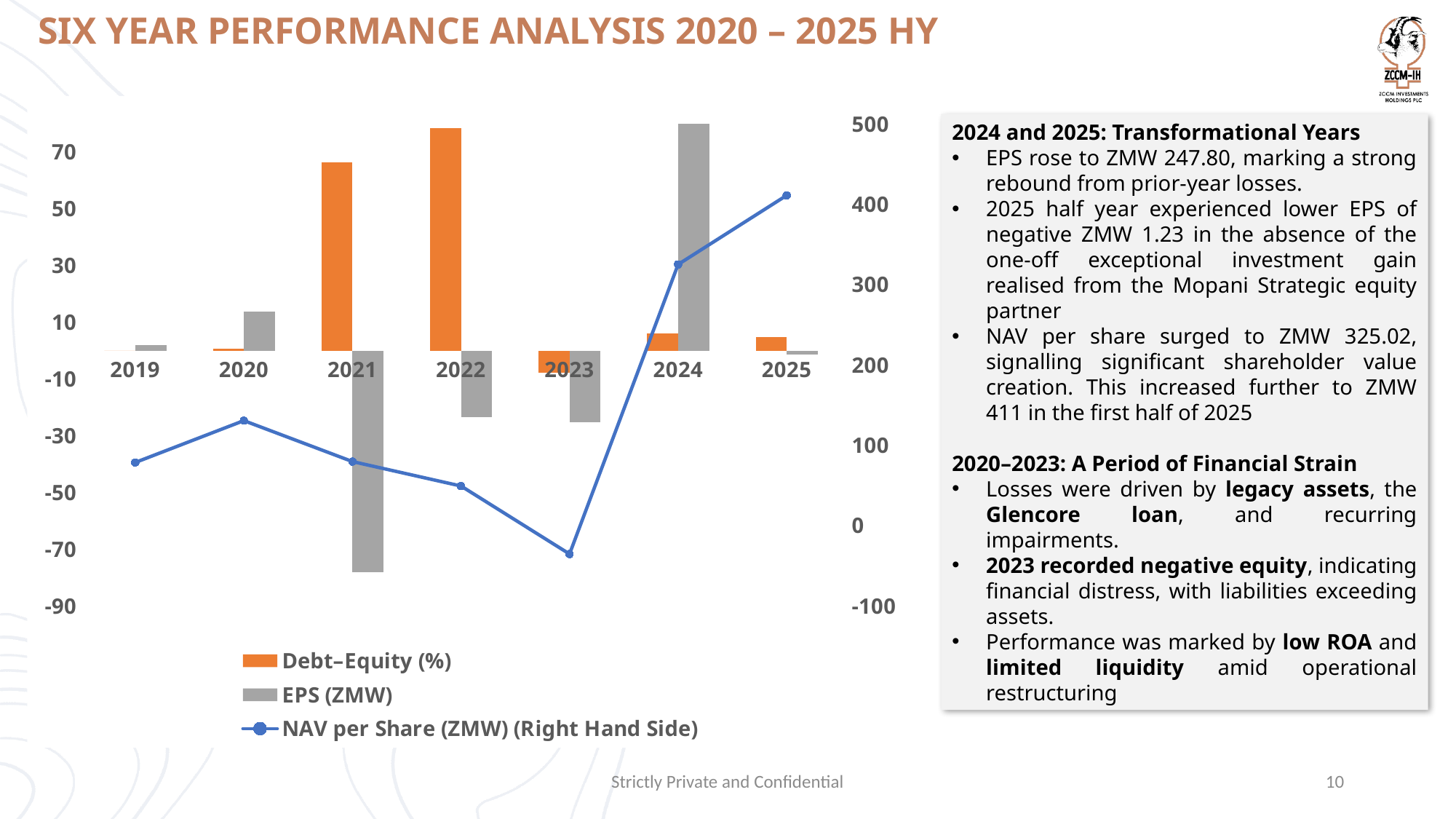
How many years are shown on the x axis of the chart? 7 In which year is Debt–Equity (%) highest? 2022 Is the NAV per Share (ZMW) value for 2024 greater or less than 300? greater Is the EPS (ZMW) value for 2021 greater or less than -50? less Which series is plotted on the right-hand axis? NAV per Share (ZMW) In which year is EPS (ZMW) highest? 2024 What type of chart is shown on the slide? Combined bar and line chart In which year is EPS (ZMW) lowest? 2021 Is the Debt–Equity (%) value for 2021 greater or less than 50? greater In which year is NAV per Share (ZMW) lowest? 2023 How many series does the chart legend list? 3 Does NAV per Share (ZMW) rise or fall from 2023 to 2025? rise